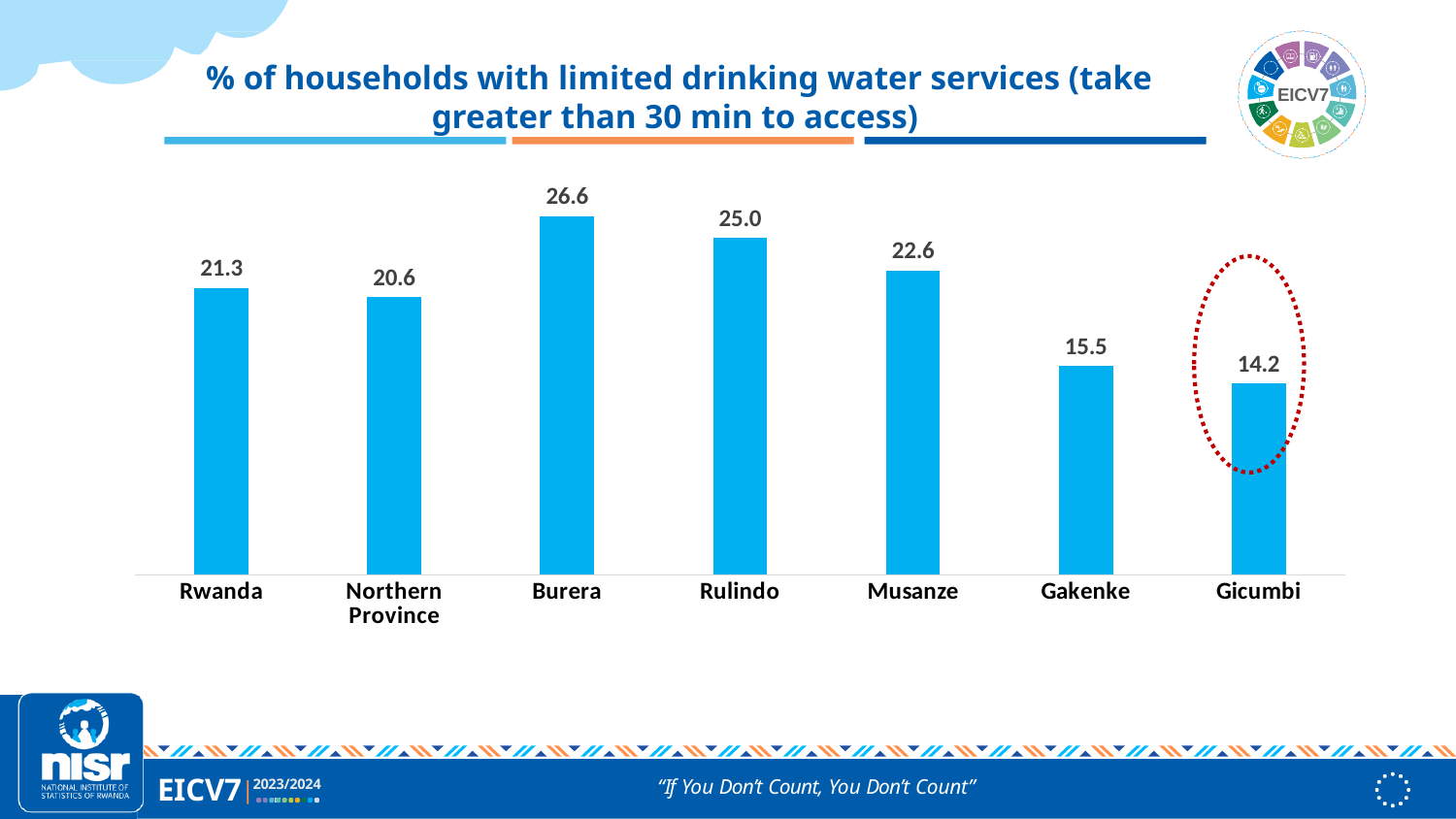
How many categories are shown on the x axis? 7 Which category has the highest value? Burera What is the value for Gicumbi? 14.2 Which category is highlighted with a red dotted circle? Gicumbi What is the value for Northern Province? 20.6 Which is larger, the value for Musanze or the value for Gakenke? Musanze What kind of chart is shown on the slide? Bar chart What is the difference between the values for Rulindo and Musanze? 2.4 What is the value for Rwanda? 21.3 Which category has the lowest value? Gicumbi What is the difference between the values for Burera and Gicumbi? 12.4 What is the value for Burera? 26.6